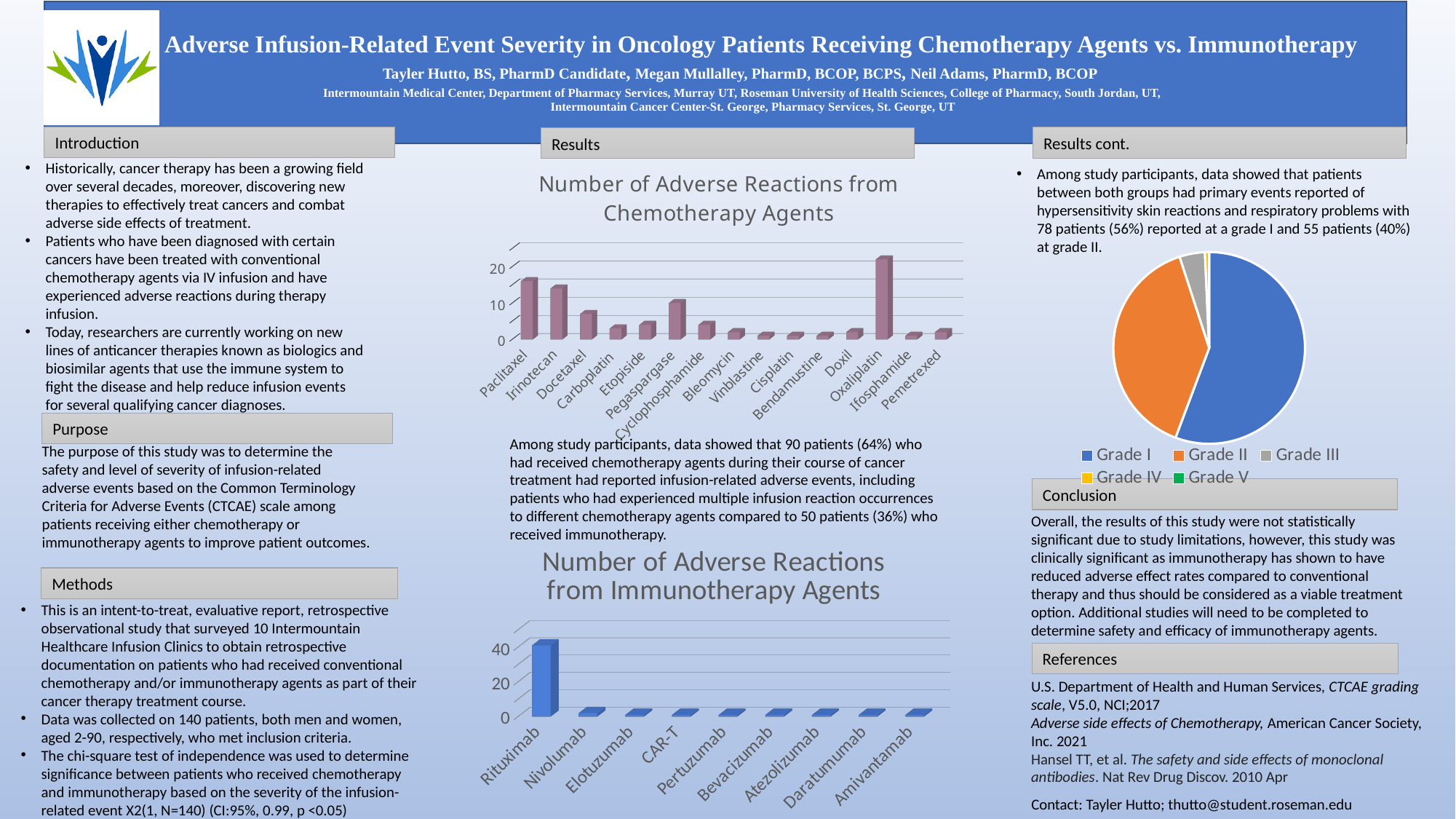
In the chart titled "Number of Adverse Reactions from Chemotherapy Agents", is the value for Oxaliplatin greater or less than 20? greater In the chart titled "Number of Adverse Reactions from Chemotherapy Agents", is the value for Paclitaxel greater or less than 10? greater In the chart titled "Number of Adverse Reactions from Immunotherapy Agents", which agent has the highest number of adverse reactions? Rituximab In the pie chart on the right side of the slide, which grade has the largest slice? Grade I In the chart titled "Number of Adverse Reactions from Chemotherapy Agents", which has more adverse reactions, Paclitaxel or Carboplatin? Paclitaxel In the chart titled "Number of Adverse Reactions from Chemotherapy Agents", how many chemotherapy agents are shown on the x axis? 15 What kind of chart is "Number of Adverse Reactions from Immunotherapy Agents"? bar chart In the chart titled "Number of Adverse Reactions from Chemotherapy Agents", is the value for Docetaxel greater or less than 10? less In the chart titled "Number of Adverse Reactions from Chemotherapy Agents", which agent has the highest number of adverse reactions? Oxaliplatin In the chart titled "Number of Adverse Reactions from Immunotherapy Agents", how many immunotherapy agents are shown on the x axis? 9 In the pie chart on the right side of the slide, how many grades does the legend list? 5